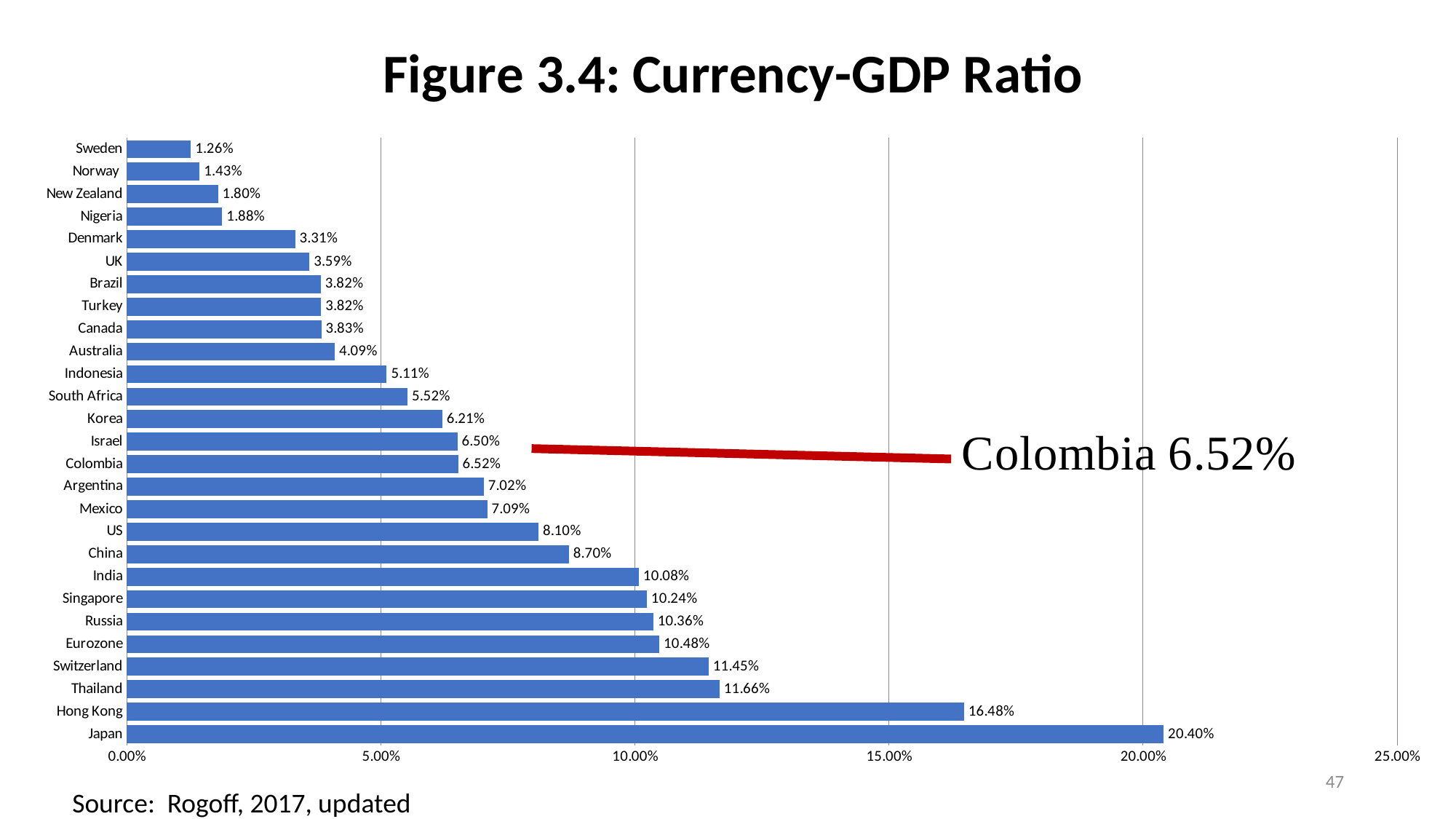
What is the currency-GDP ratio for Japan? 20.40% Is the currency-GDP ratio for Switzerland greater or less than 10.00%? greater Which country has the highest currency-GDP ratio? Japan What is the difference between the currency-GDP ratios of Japan and Hong Kong? 3.92% What is the source cited for the chart? Rogoff, 2017, updated Which has a higher currency-GDP ratio, China or India? India Which country has the lowest currency-GDP ratio? Sweden What type of chart is shown on the slide? Bar chart What is the currency-GDP ratio for the US? 8.10% What is the title of the chart? Figure 3.4: Currency-GDP Ratio What is the currency-GDP ratio for Colombia? 6.52% How many countries or regions are shown in the chart? 27